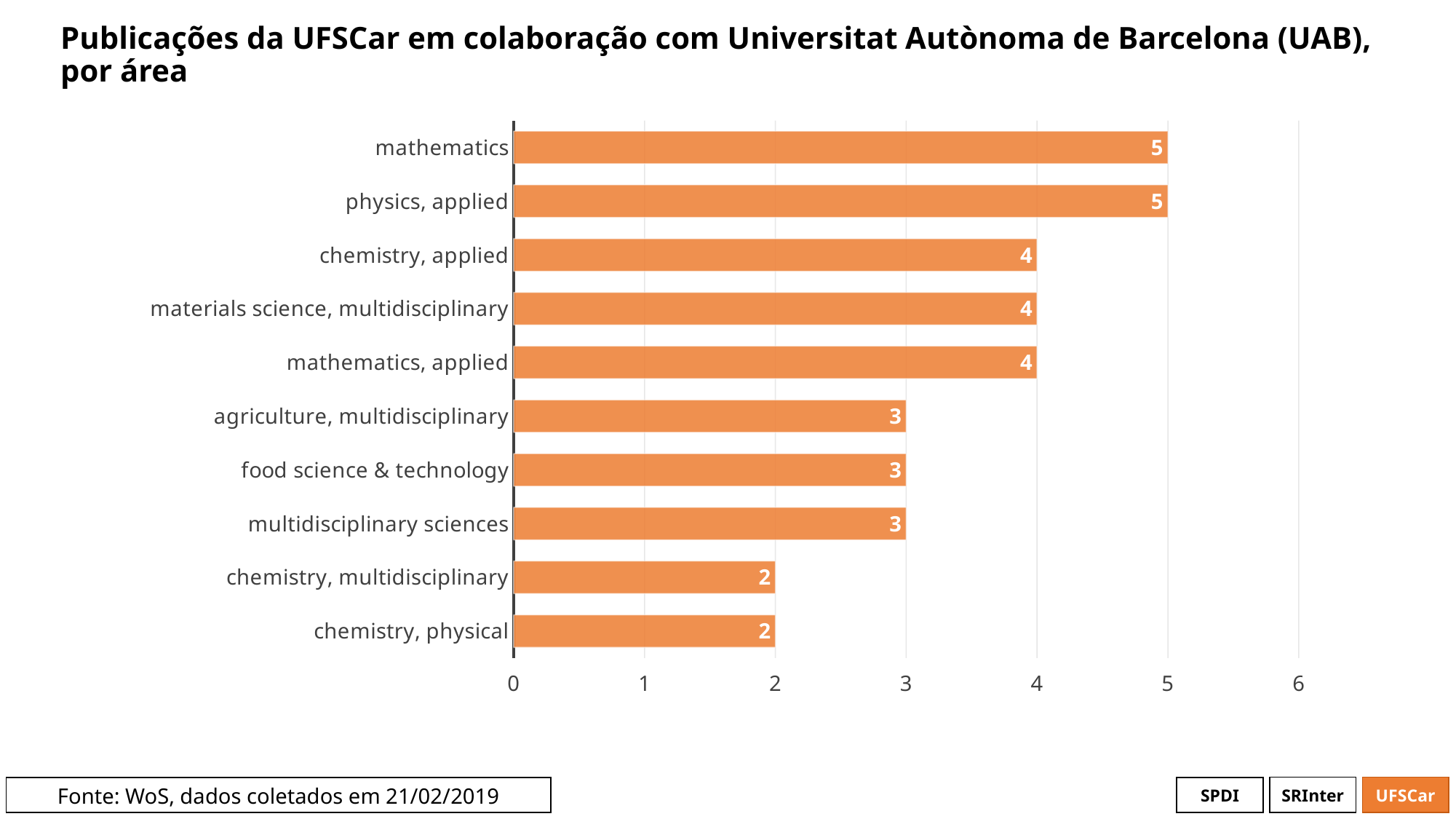
Which categories have the lowest value? chemistry, multidisciplinary and chemistry, physical What is the difference between the values for mathematics and agriculture, multidisciplinary? 2 What is the value for physics, applied? 5 Which is larger, the value for materials science, multidisciplinary or the value for multidisciplinary sciences? materials science, multidisciplinary Is the value for mathematics, applied greater or less than 3? greater What is the data source stated at the bottom of the slide? WoS, dados coletados em 21/02/2019 How many categories are shown in the chart? 10 What kind of chart is shown on the slide? bar chart Which categories have the highest value? mathematics and physics, applied What is the value for food science & technology? 3 What is the value for chemistry, physical? 2 What is the value for chemistry, applied? 4